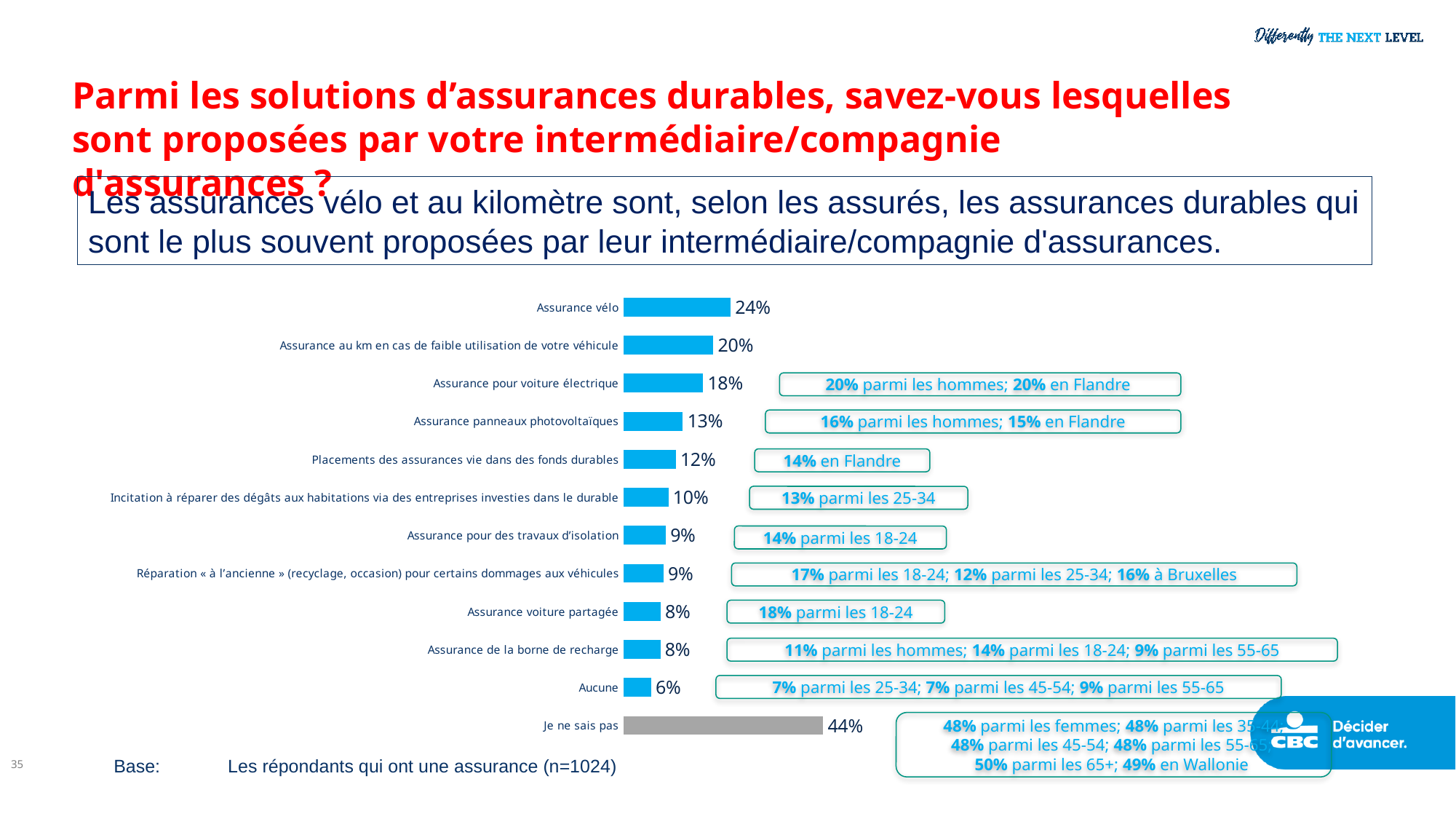
What is the value for "Assurance au km en cas de faible utilisation de votre véhicule"? 20% What is the value for "Je ne sais pas"? 44% What is the value for "Assurance panneaux photovoltaïques"? 13% What is the value for "Assurance vélo"? 24% What colour is the bar for "Je ne sais pas"? Grey How many categories are shown in the chart? 12 What is the value for "Aucune"? 6% What is the difference between the values for "Assurance vélo" and "Assurance pour voiture électrique"? 6% Which category has the lowest value? Aucune What kind of chart is shown on the slide? Bar chart Which is larger: the value for "Assurance pour voiture électrique" or the value for "Placements des assurances vie dans des fonds durables"? Assurance pour voiture électrique Which category has the highest value? Je ne sais pas